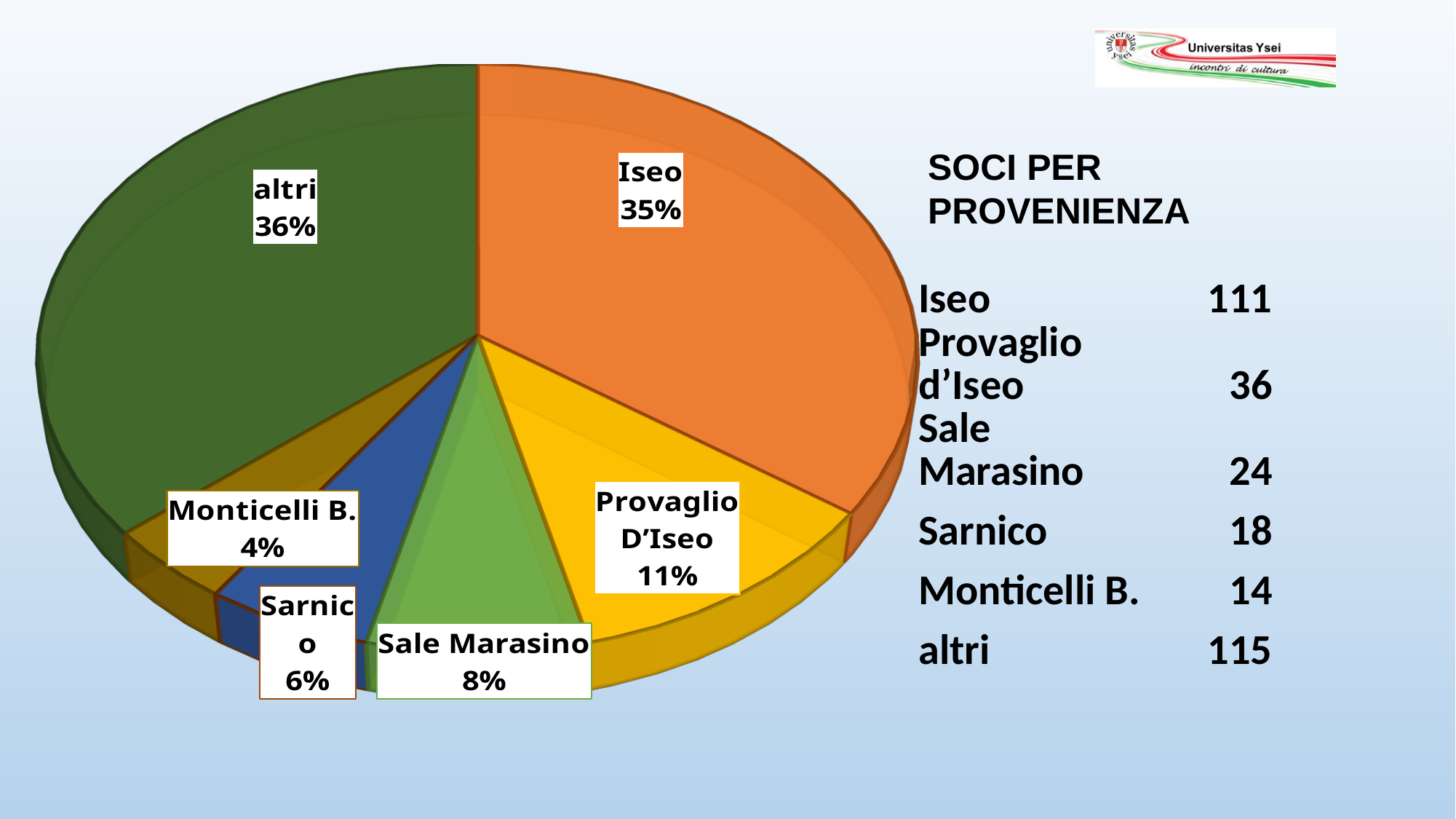
What is the difference in percentage points between Iseo and Provaglio D'Iseo? 24 What colour is the Iseo slice? orange What kind of chart is shown on the slide? pie chart Which slice of the pie is the largest? altri What is the title of the chart? SOCI PER PROVENIENZA Which slice of the pie is the smallest? Monticelli B. What percentage is shown for Monticelli B.? 4% What percentage of the pie does the Iseo slice represent? 35% What percentage is shown for Provaglio D'Iseo? 11% What percentage is shown for Sale Marasino? 8% How many slices does the pie chart have? 6 Which is larger, the Sale Marasino slice or the Sarnico slice? Sale Marasino